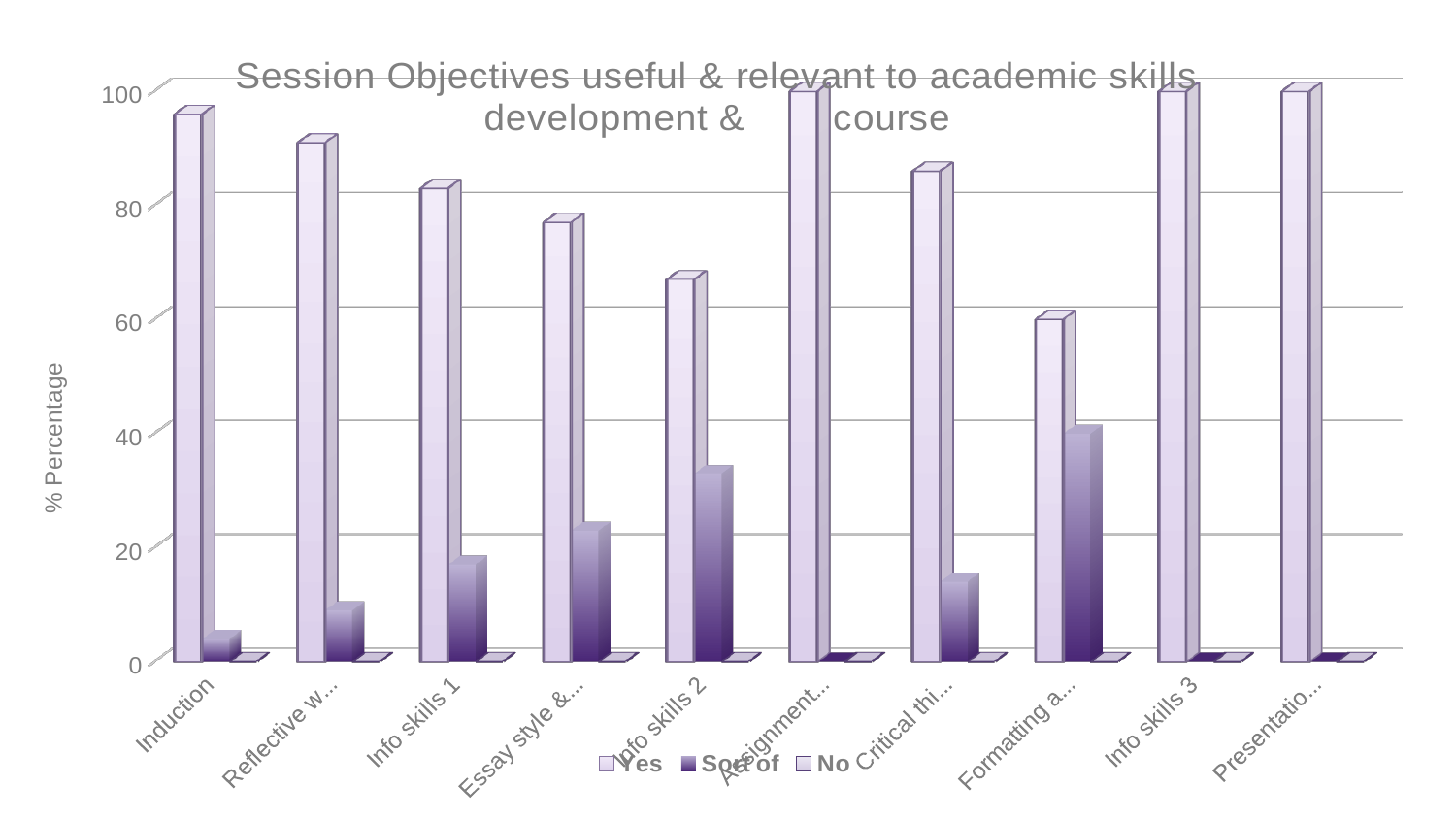
How many categories are shown along the x axis? 10 Is the 'Sort of' value for Formatting a... greater or less than 20? greater Which has the larger 'Sort of' value, Info skills 1 or Info skills 2? Info skills 2 Which category has the lowest 'Yes' value? Formatting a... What kind of chart is shown on the slide? bar chart Is the 'Yes' value for Info skills 2 greater or less than 80? less Which category has the highest 'Sort of' value? Formatting a... What is the label on the vertical axis? % Percentage How many series does the legend list? 3 Which has the larger 'Yes' value, Induction or Info skills 2? Induction Is the 'Yes' value for Induction greater or less than 80? greater